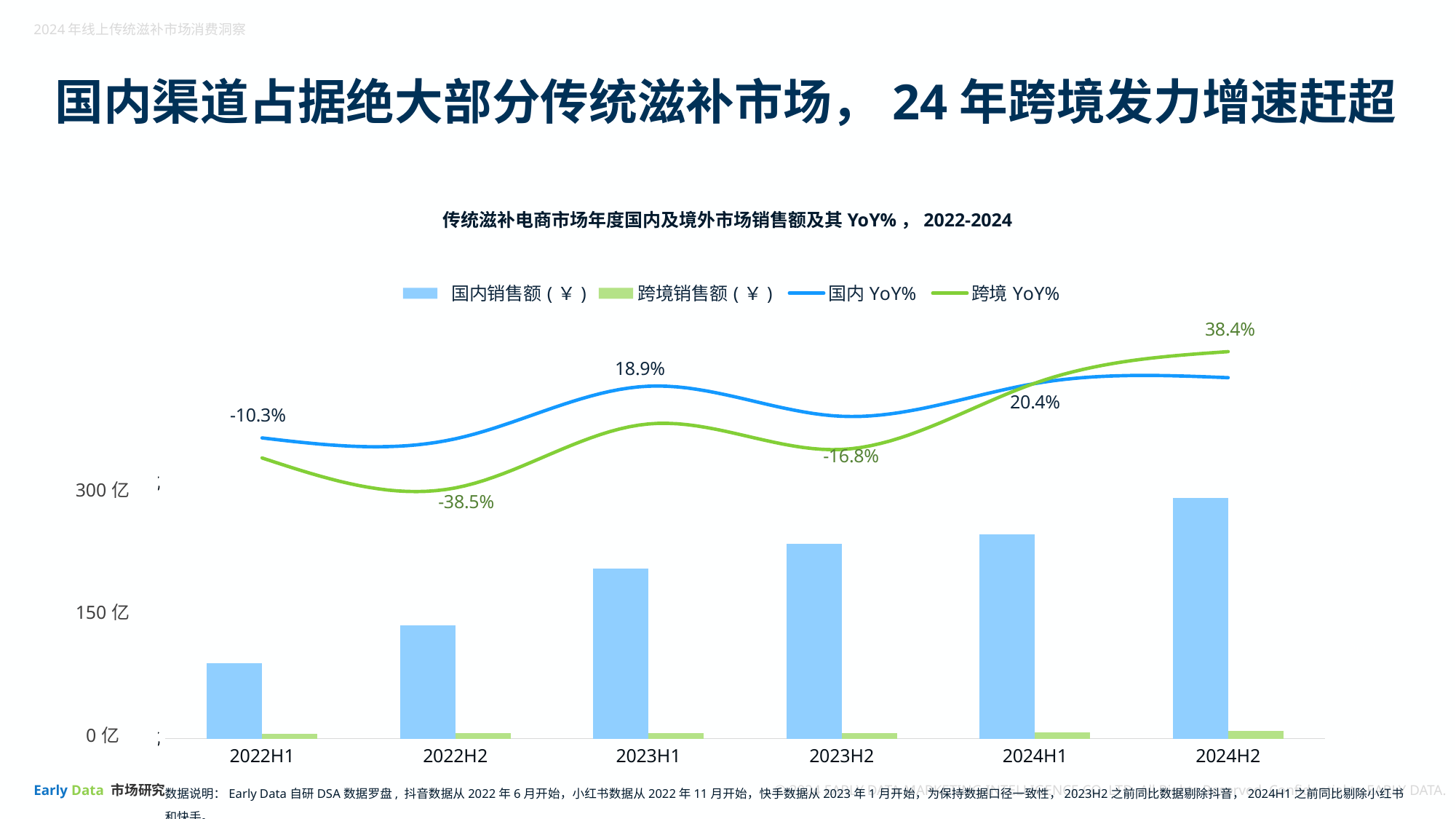
Is the 国内销售额（￥） for 2022H1 greater or less than 150 亿? less How many series does the chart legend list? 4 What is the 跨境 YoY% value for 2024H2? 38.4% What is the 国内 YoY% value for 2022H1? -10.3% What is the difference between the 跨境 YoY% for 2024H2 and for 2022H2? 76.9 percentage points What is the 国内 YoY% value for 2023H1? 18.9% What kind of chart is used to show 国内销售额（￥） on this slide? Bar chart What is the 跨境 YoY% value for 2023H2? -16.8% Which period has the highest 国内销售额（￥）? 2024H2 What is the 跨境 YoY% value for 2022H2? -38.5% Which period has the lowest 国内销售额（￥）? 2022H1 How many time periods are shown on the x axis of the chart? 6